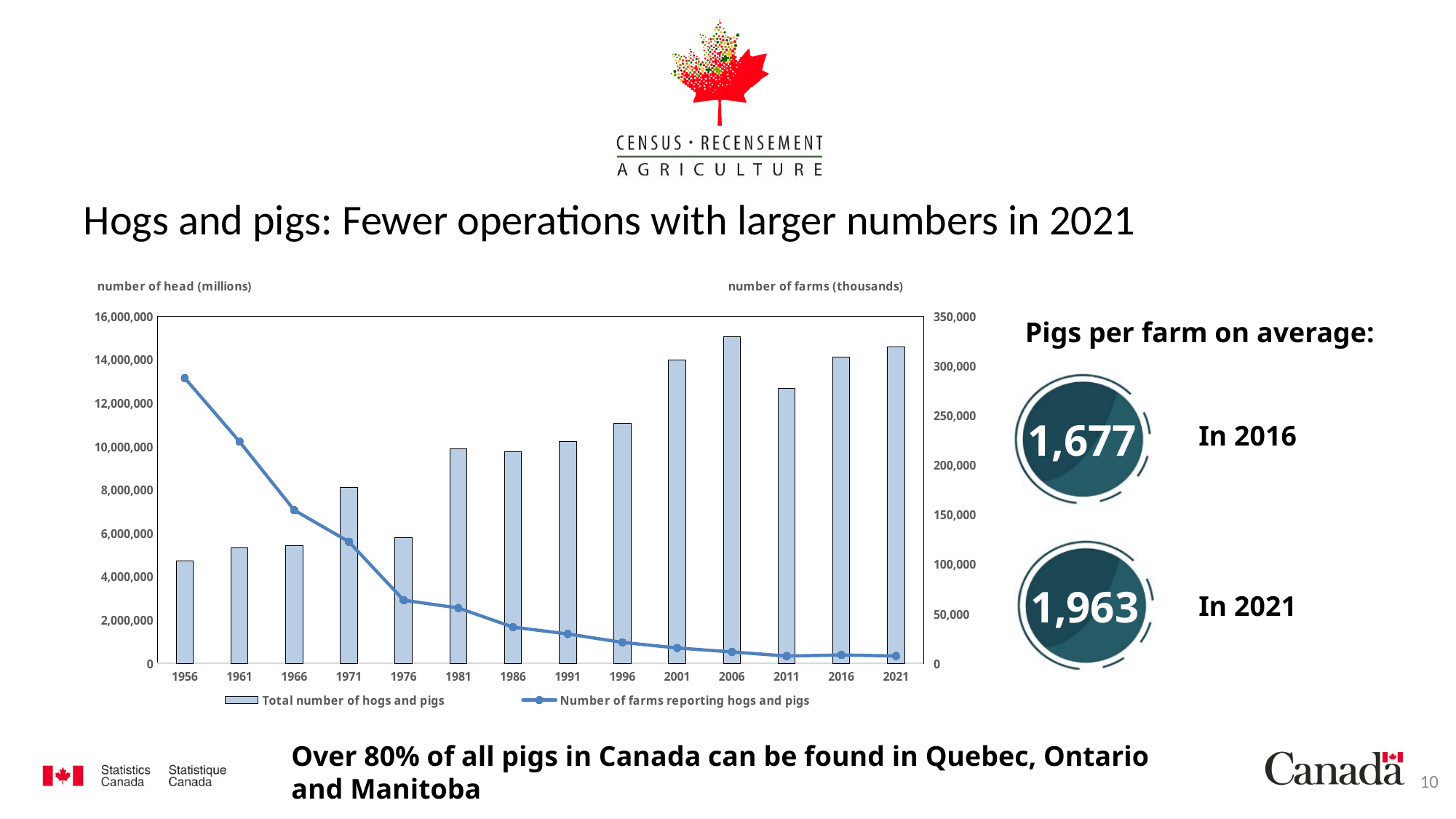
In which year is the number of farms reporting hogs and pigs the highest? 1956 Is the total number of hogs and pigs in 2011 greater or less than 14,000,000? less In which year is the bar for total number of hogs and pigs the lowest? 1956 Is the number of farms reporting hogs and pigs in 2021 greater or less than 50,000? less How many census years are shown on the x axis of the chart? 14 In which year is the bar for total number of hogs and pigs the highest? 2006 What type of chart is shown on the slide? Combined bar and line chart Which year has a larger total number of hogs and pigs, 1971 or 1976? 1971 Is the total number of hogs and pigs in 2006 greater or less than 14,000,000? greater Does the number of farms reporting hogs and pigs rise or fall from 1956 to 2021? fall How many series does the chart legend list? 2